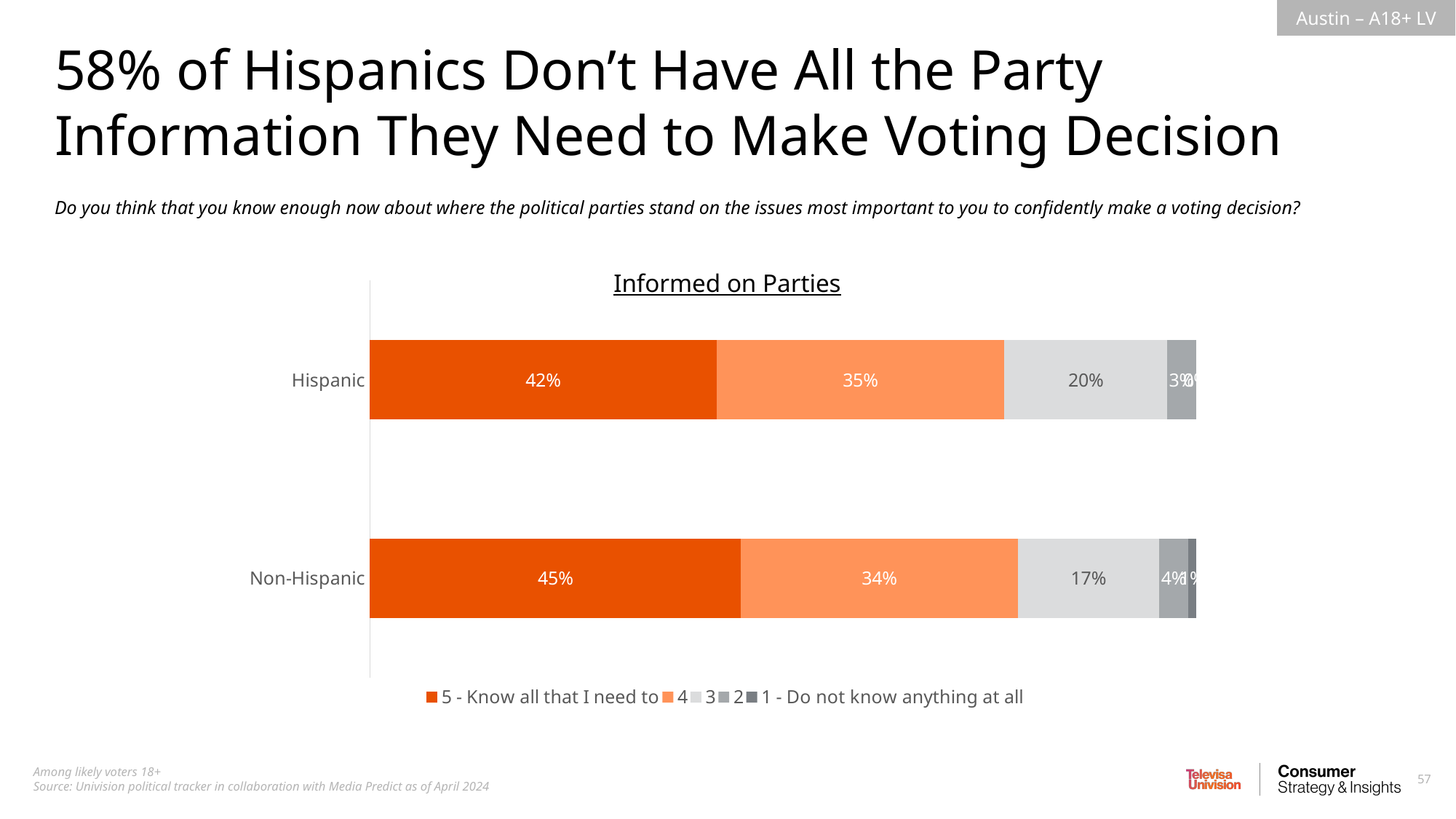
What percentage of Hispanic respondents answered "5 - Know all that I need to"? 42% What is the value of the "4" segment for Non-Hispanic respondents? 34% What percentage of Non-Hispanic respondents gave a rating of "3"? 17% How many groups (bars) are shown in the chart? 2 What is the value of the "4" segment for Hispanic respondents? 35% What is the difference between the Hispanic and Non-Hispanic shares for rating "3"? 3 percentage points How many series does the legend list? 5 Which group has the higher share answering "5 - Know all that I need to", Hispanic or Non-Hispanic? Non-Hispanic Which response segment is the largest in the Hispanic bar? 5 - Know all that I need to What type of chart is shown on the slide? Stacked bar chart What percentage of Non-Hispanic respondents answered "5 - Know all that I need to"? 45% What percentage of Hispanic respondents gave a rating of "3"? 20%